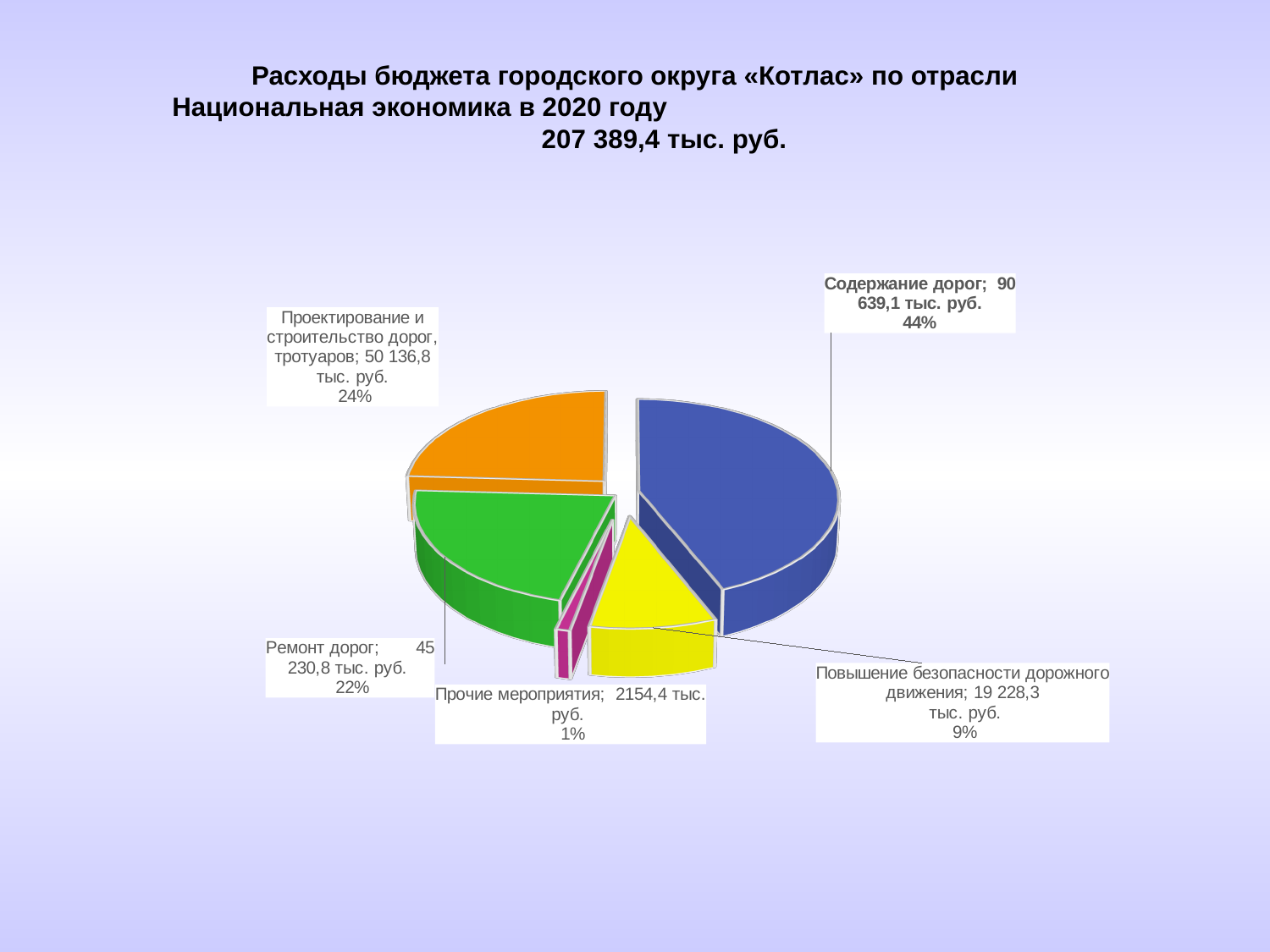
What share of the pie does Содержание дорог take? 44% Which category has the largest value? Содержание дорог Which category has the smallest value? Прочие мероприятия What type of chart is shown on the slide? Pie chart What is the value for Повышение безопасности дорожного движения? 19 228,3 тыс. руб. What is the value for Прочие мероприятия? 2154,4 тыс. руб. What is the value for Содержание дорог? 90 639,1 тыс. руб. What share of the pie does Проектирование и строительство дорог, тротуаров take? 24% Which is larger, Ремонт дорог or Повышение безопасности дорожного движения? Ремонт дорог How many slices does the pie chart have? 5 What is the difference between Проектирование и строительство дорог, тротуаров and Ремонт дорог? 4 906,0 тыс. руб. What is the value for Ремонт дорог? 45 230,8 тыс. руб.